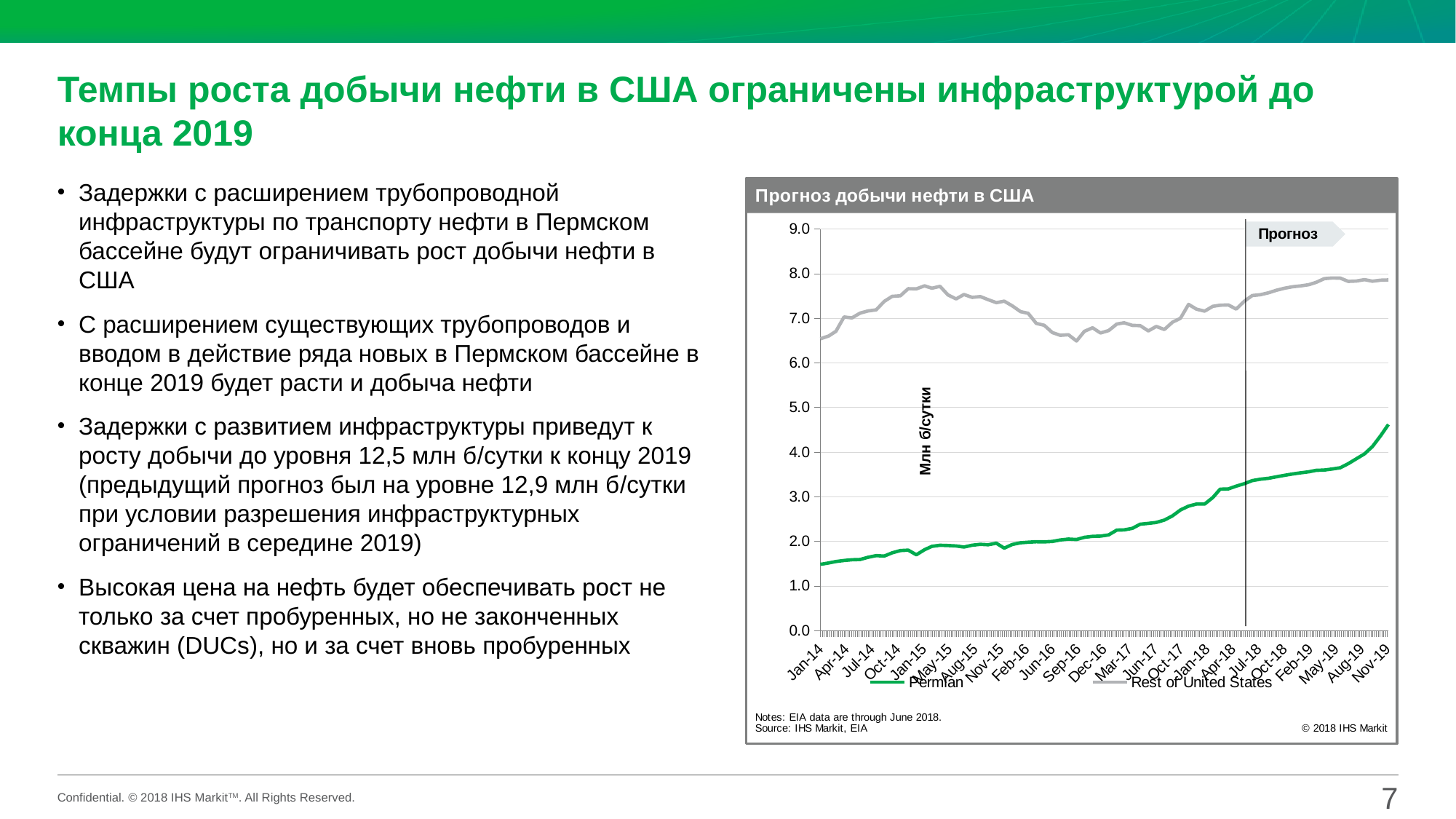
What is the title of the chart? Прогноз добычи нефти в США How many series does the chart's legend list? 2 Is the value for Permian at Jan-14 greater or less than 2.0? less What kind of chart is shown on the slide? line chart Is the value for Permian at Nov-19 greater or less than 4.0? greater Is the value for Rest of United States at Nov-19 greater or less than 7.0? greater Which series has the lower value at Jan-14, Permian or Rest of United States? Permian What unit is shown on the chart's vertical axis? Млн б/сутки Which series has the higher value at Nov-19, Permian or Rest of United States? Rest of United States Does the Permian series rise or fall from Jan-14 to Nov-19? rise